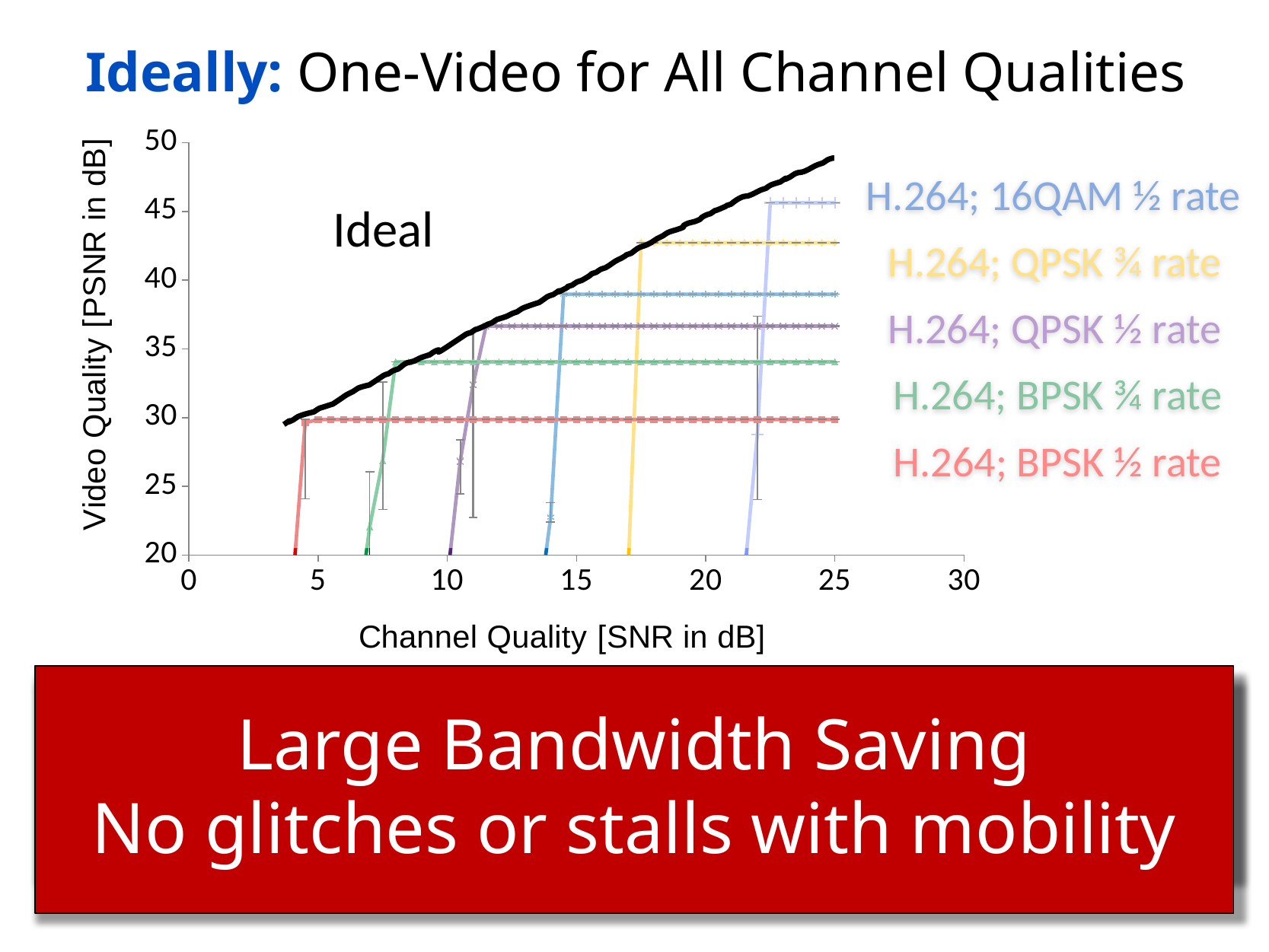
Is the plateau PSNR of H.264; BPSK ¾ rate greater or less than 35? less Which H.264 series reaches the highest video quality (PSNR)? H.264; 16QAM ½ rate Which H.264 series has the lowest plateau video quality (PSNR)? H.264; BPSK ½ rate Does the Ideal curve rise or fall as Channel Quality increases? rise What is the label of the x axis? Channel Quality [SNR in dB] Is the plateau PSNR of H.264; QPSK ¾ rate greater or less than 40? greater Is the plateau PSNR of H.264; QPSK ½ rate greater or less than 35? greater What colour is the Ideal curve drawn in? black What kind of chart is shown on the slide? line chart Which reaches a higher plateau PSNR: H.264; QPSK ½ rate or H.264; BPSK ¾ rate? H.264; QPSK ½ rate How many H.264 series does the legend on the right list? 5